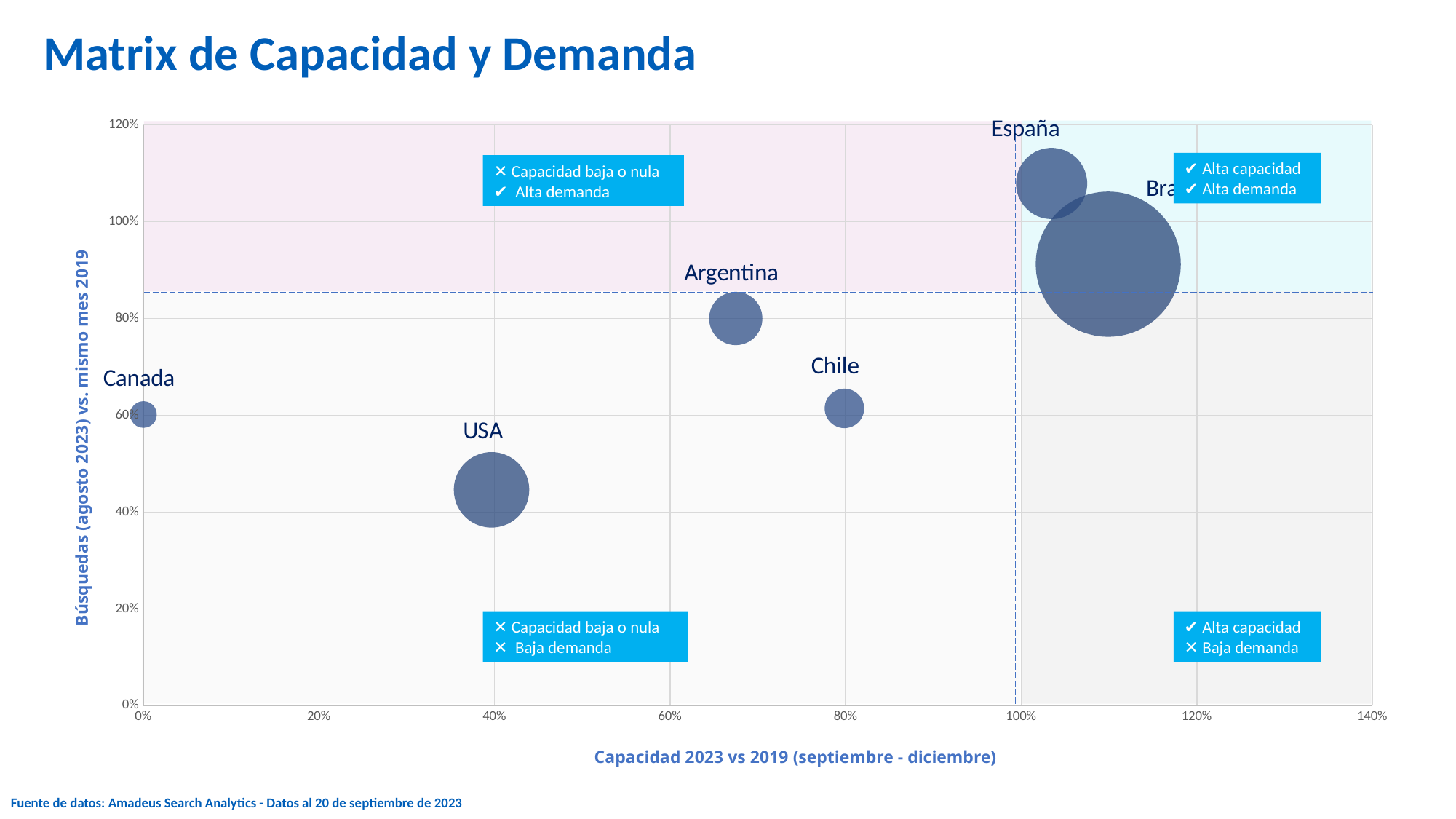
What is the title of the chart on the slide? Matrix de Capacidad y Demanda Which country has the highest value on the vertical axis (Búsquedas)? España What kind of chart is shown on the slide? Bubble chart Which country has the lowest value on the horizontal axis (Capacidad)? Canada Is the vertical-axis value for USA greater or less than 60%? less What is the label of the horizontal axis? Capacidad 2023 vs 2019 (septiembre - diciembre) Which country has the lowest value on the vertical axis (Búsquedas)? USA Which country has a higher vertical-axis value, Argentina or Chile? Argentina Which country has a higher horizontal-axis value, USA or Chile? Chile Is the vertical-axis value for España greater or less than 100%? greater Is the horizontal-axis value for Argentina greater or less than 60%? greater How many countries are plotted as bubbles on the chart? 6